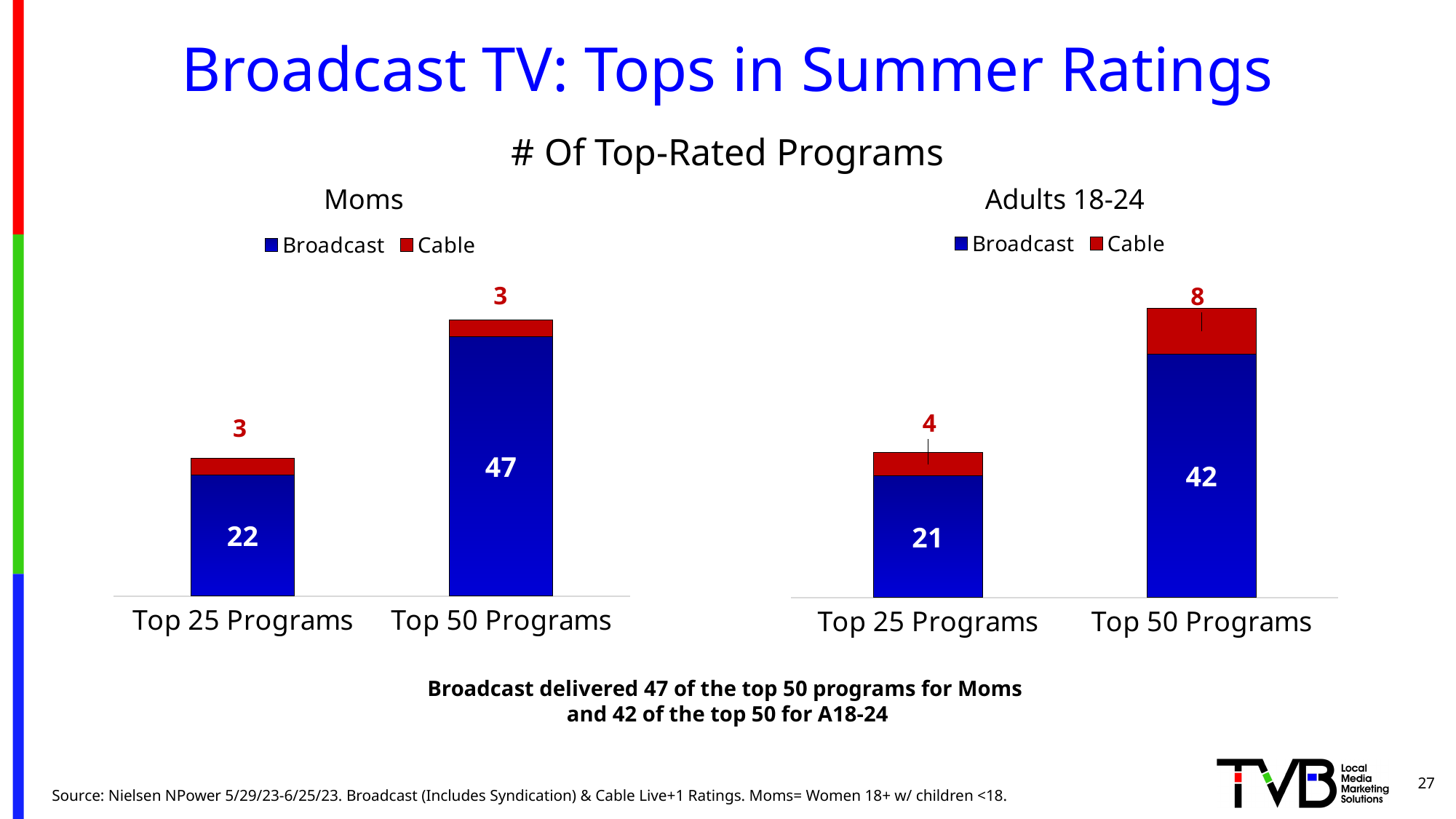
In the Moms chart, what is the Broadcast value for Top 50 Programs? 47 In the Adults 18-24 chart, what is the Broadcast value for Top 25 Programs? 21 In the Moms chart, which category has the higher Broadcast value? Top 50 Programs How many categories are shown on the x axis of the Moms chart? 2 In the Adults 18-24 chart, what is the difference between the Broadcast values for Top 50 Programs and Top 25 Programs? 21 How many series does the legend of the Adults 18-24 chart list? 2 Is the Broadcast value for Top 50 Programs larger in the Moms chart or the Adults 18-24 chart? Moms In the Moms chart, what is the total of the stacked bar for Top 25 Programs? 25 In the Adults 18-24 chart, what is the Cable value for Top 50 Programs? 8 In the Adults 18-24 chart, what is the total of the stacked bar for Top 50 Programs? 50 What kind of chart is the Moms chart? Stacked bar chart In the Moms chart, what is the Cable value for Top 25 Programs? 3